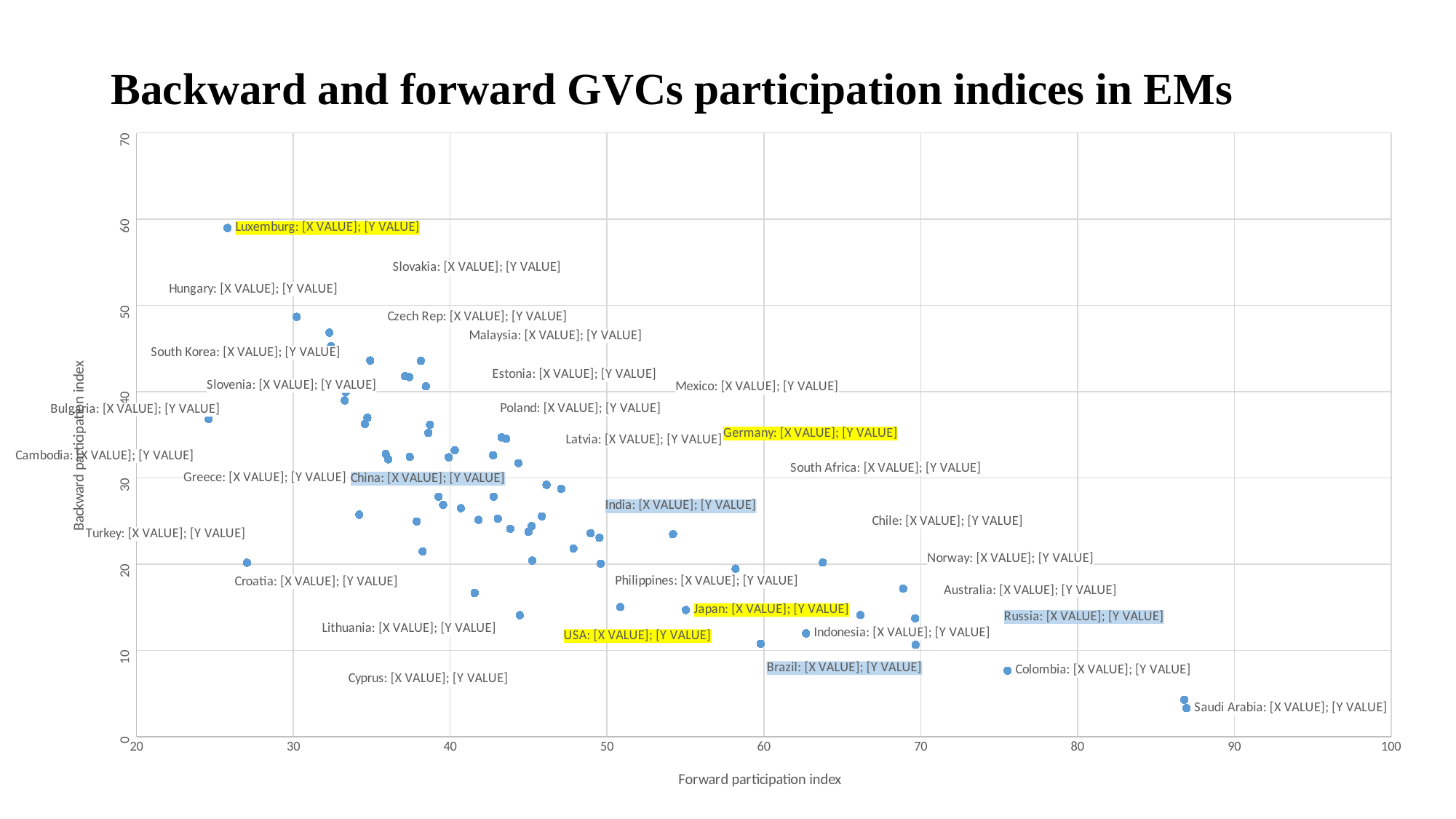
Which country has the highest forward participation index? Saudi Arabia What is the label of the horizontal axis? Forward participation index Is the forward participation index for Colombia greater or less than 70? greater What is the title of the chart? Backward and forward GVCs participation indices in EMs Which country has the highest backward participation index? Luxemburg Is the backward participation index for Saudi Arabia greater or less than 10? less Which has the larger backward participation index, Luxemburg or Saudi Arabia? Luxemburg Is the forward participation index for Luxemburg greater or less than 30? less Which country has the lowest backward participation index? Saudi Arabia What kind of chart is shown on the slide? Scatter chart